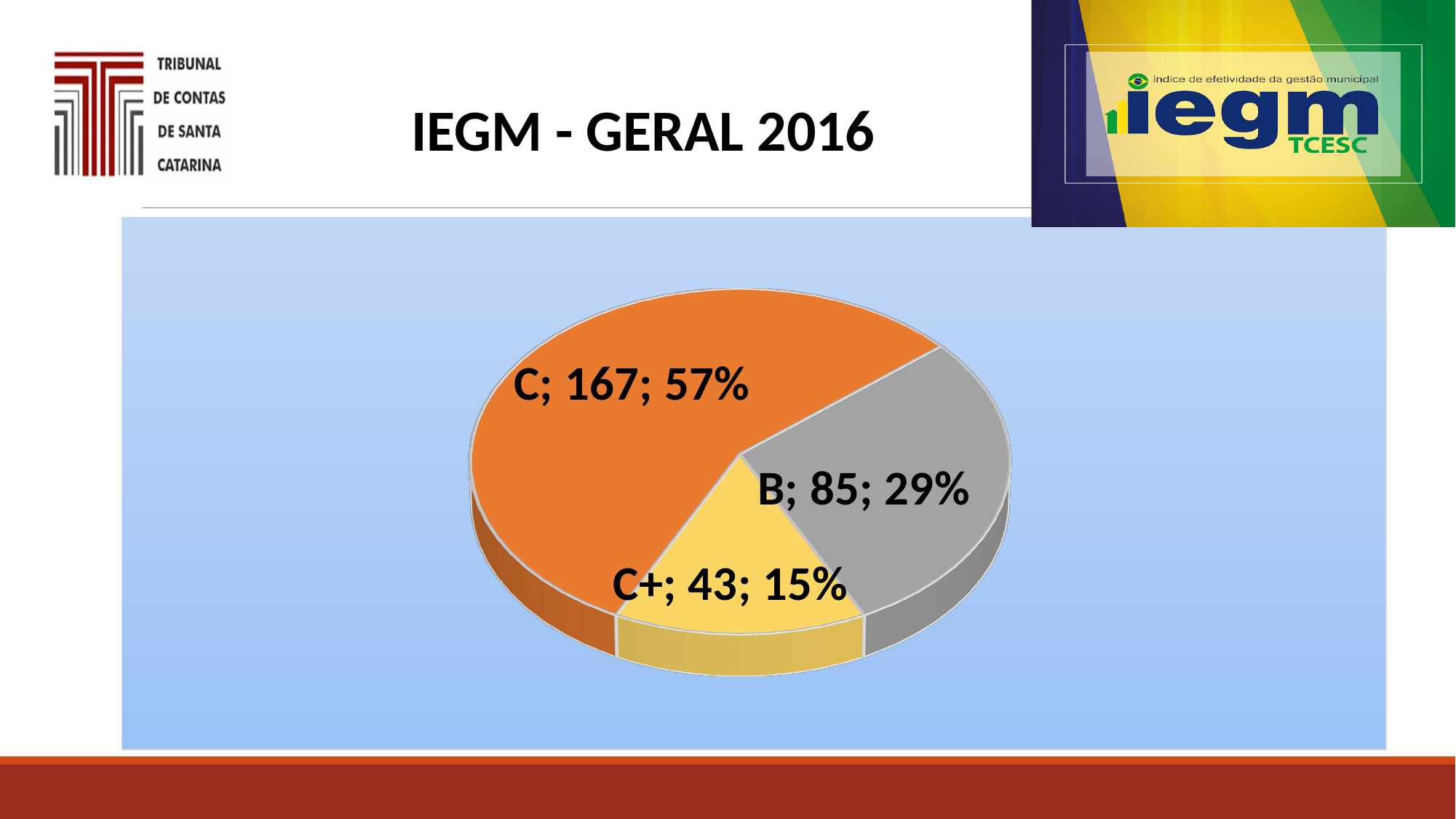
Which category has the smallest slice? C+ What share of the pie does category C+ represent? 15% What is the value for category C? 167 Which is larger, the value for B or the value for C+? B What kind of chart is shown on the slide? pie chart What is the value for category C+? 43 Which category has the largest slice? C What is the difference between the values for C and B? 82 What is the value for category B? 85 What share of the pie does category B represent? 29% What is the title of the chart? IEGM - GERAL 2016 How many categories does the pie chart have? 3